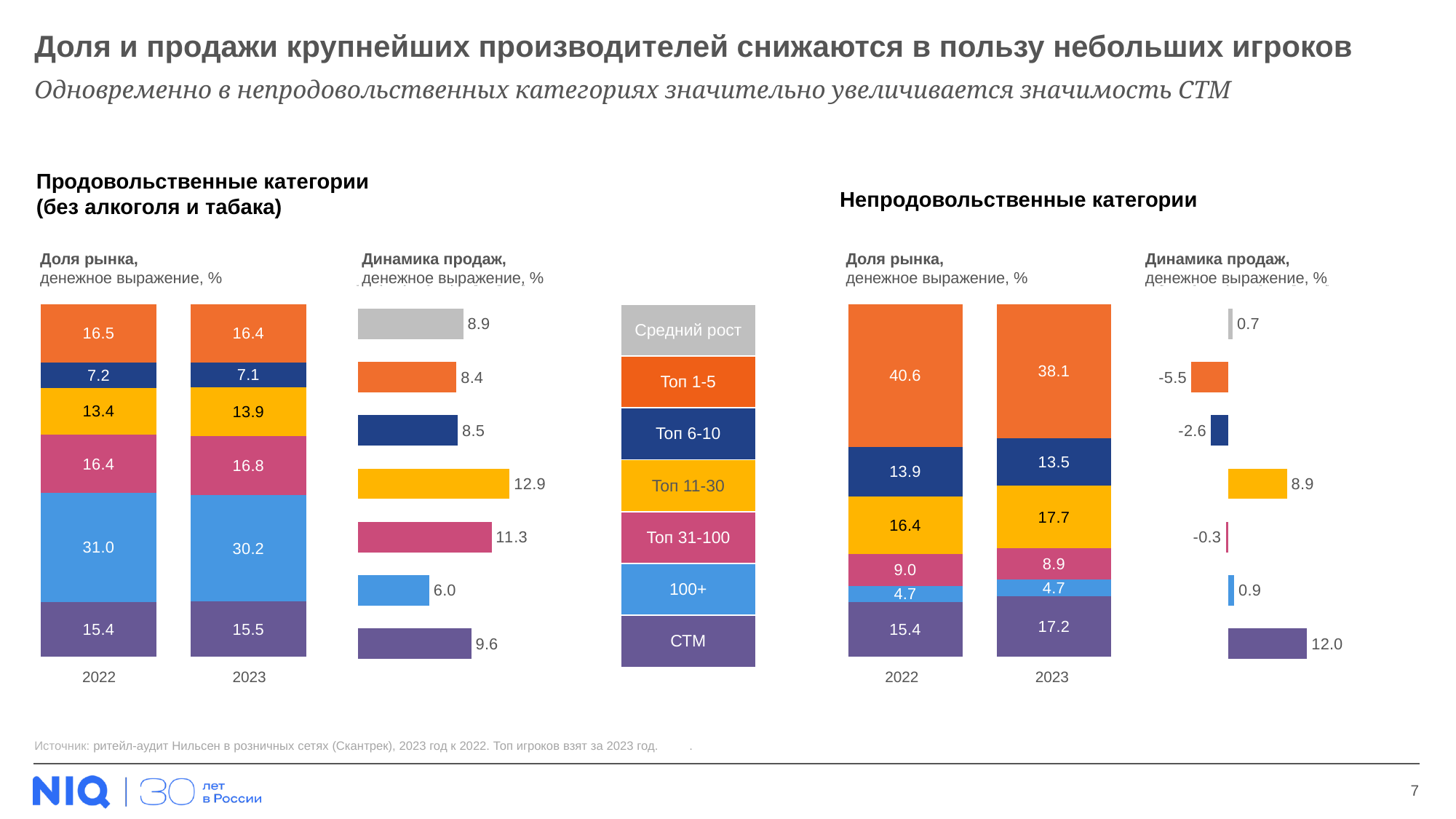
In the non-food categories sales dynamics chart (right), what is the value for Топ 1-5? -5.5 In the non-food categories market share chart (right), which segment has the largest share in 2022? Топ 1-5 In the non-food categories sales dynamics chart (right), is the value for СТМ larger or smaller than the value for Топ 11-30? larger What type of chart is used for the sales dynamics (Динамика продаж) on the slide? bar chart In the food categories market share chart (left), what is the share of 100+ in 2022? 31.0 In the food categories sales dynamics chart (left), which segment has the lowest growth? 100+ In the food categories market share chart (Доля рынка, left), what is the share of Топ 1-5 in 2023? 16.4 In the non-food categories market share chart (right), what is the share of СТМ in 2023? 17.2 In the food categories sales dynamics chart (Динамика продаж, left), which segment has the highest growth? Топ 11-30 In the non-food categories sales dynamics chart (right), which segment has the highest growth? СТМ In the non-food categories market share chart (right), by how much did the Топ 1-5 share change from 2022 to 2023? -2.5 How many segments does the legend in the middle of the slide list? 7